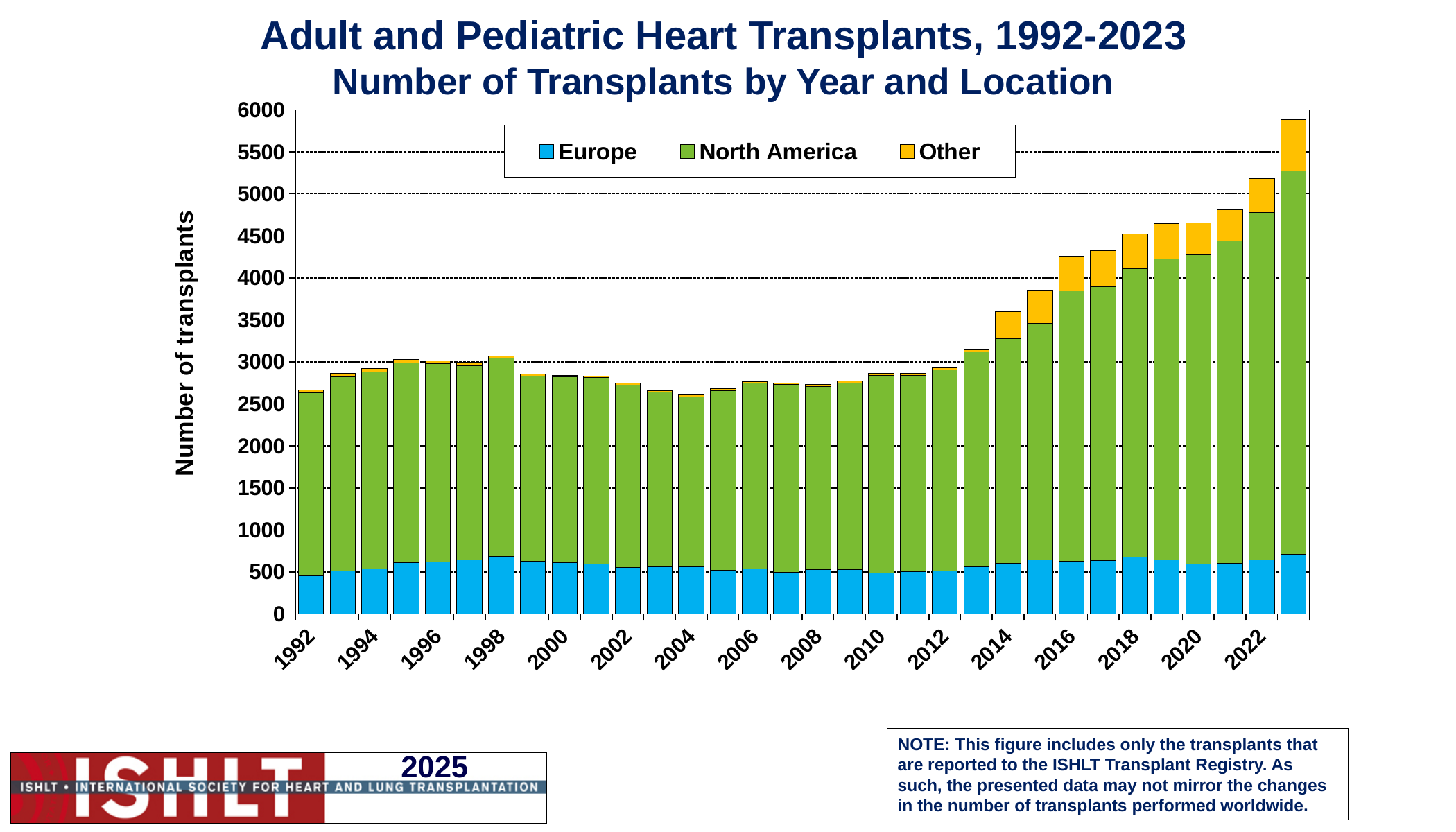
Which year has a larger total number of transplants, 1992 or 2023? 2023 Is the total number of transplants in 2022 greater or less than 5000? greater Is the total number of transplants in 2023 greater or less than 5500? greater How many years (bars) are plotted in the chart? 32 How many series does the legend list? 3 Is the total number of transplants in 2016 greater or less than 4500? less What kind of chart is shown on the slide? stacked bar chart What is the label on the vertical axis? Number of transplants Which series are listed in the legend? Europe, North America, Other Which year has the highest total number of transplants? 2023 Do the total numbers of transplants rise or fall from 2013 to 2023? rise